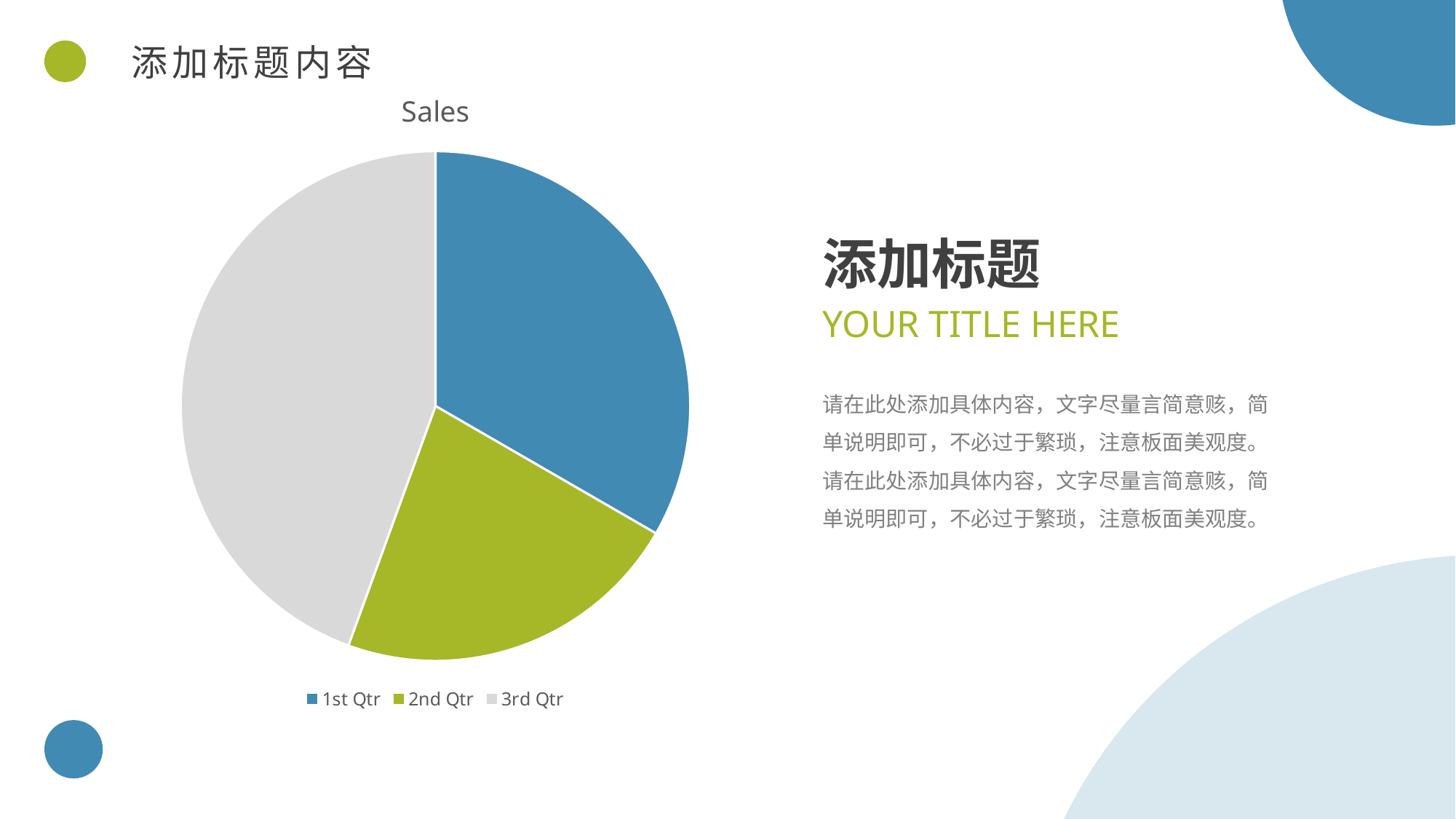
Which slice is larger, 3rd Qtr or 1st Qtr? 3rd Qtr What is the title of the chart? Sales What kind of chart is shown on the slide? pie chart Which slice is larger, 3rd Qtr or 2nd Qtr? 3rd Qtr How many entries does the chart legend list? 3 How many slices does the pie chart have? 3 Which quarter has the smallest slice of the pie? 2nd Qtr Which slice is larger, 1st Qtr or 2nd Qtr? 1st Qtr Which quarter has the largest slice of the pie? 3rd Qtr What colour is the 2nd Qtr slice in the pie chart? green